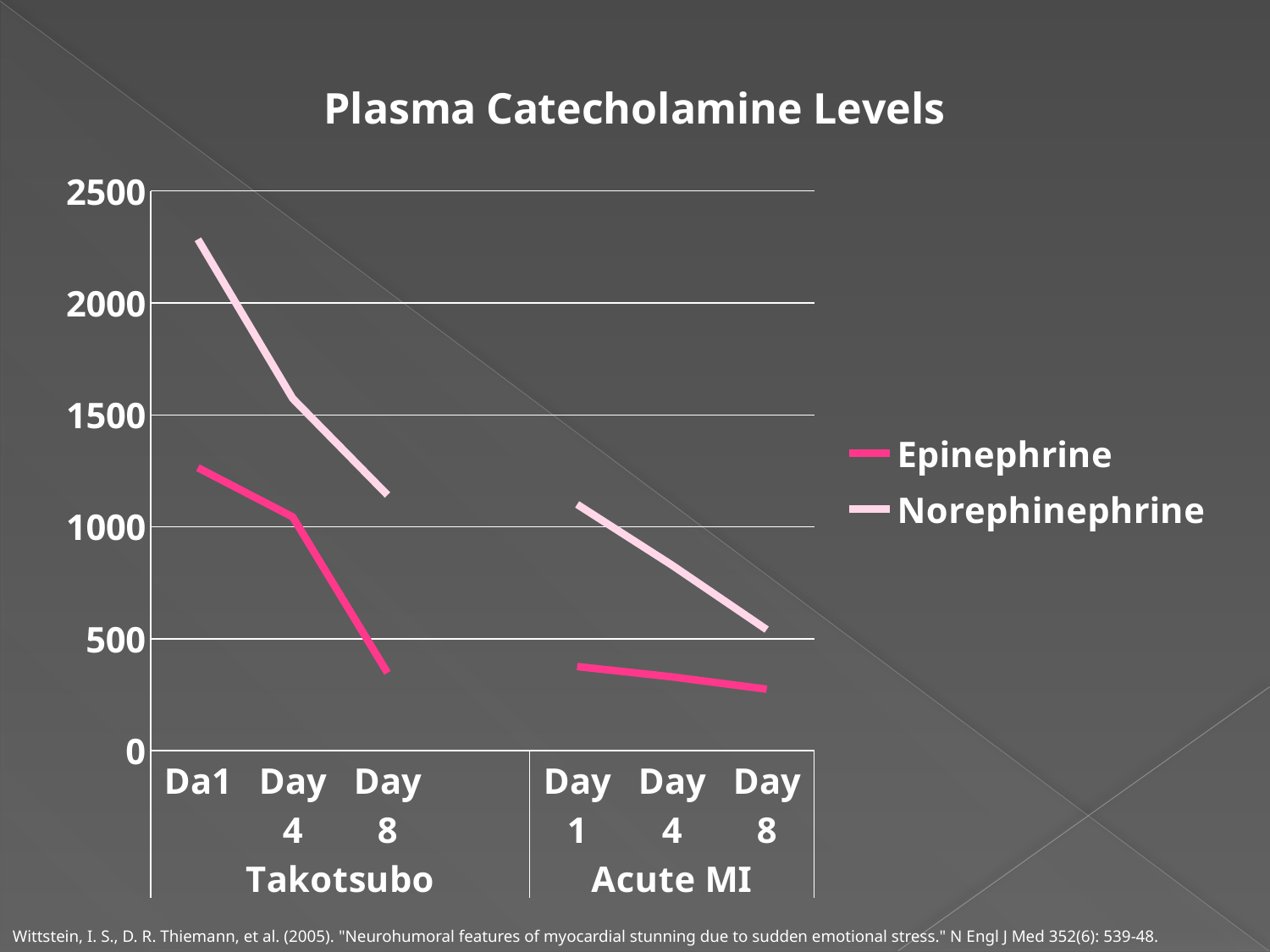
How many series does the legend list? 2 Which two series are listed in the legend? Epinephrine and Norephinephrine What is the title of the chart? Plasma Catecholamine Levels Is the Norephinephrine value for Takotsubo Day 1 (Da1) greater or less than 2000? greater Is the Norephinephrine value for Takotsubo Day 4 greater or less than 1500? greater Is the Epinephrine value for Acute MI Day 1 greater or less than 500? less How many time points (categories) are shown along the x axis in total? 6 Does the Norephinephrine level in Takotsubo patients rise or fall from Day 1 to Day 8? Fall At which time point is the Norephinephrine level highest? Takotsubo Day 1 (Da1) At which time point is the Epinephrine level lowest? Acute MI Day 8 What kind of chart is shown on the slide? Line chart